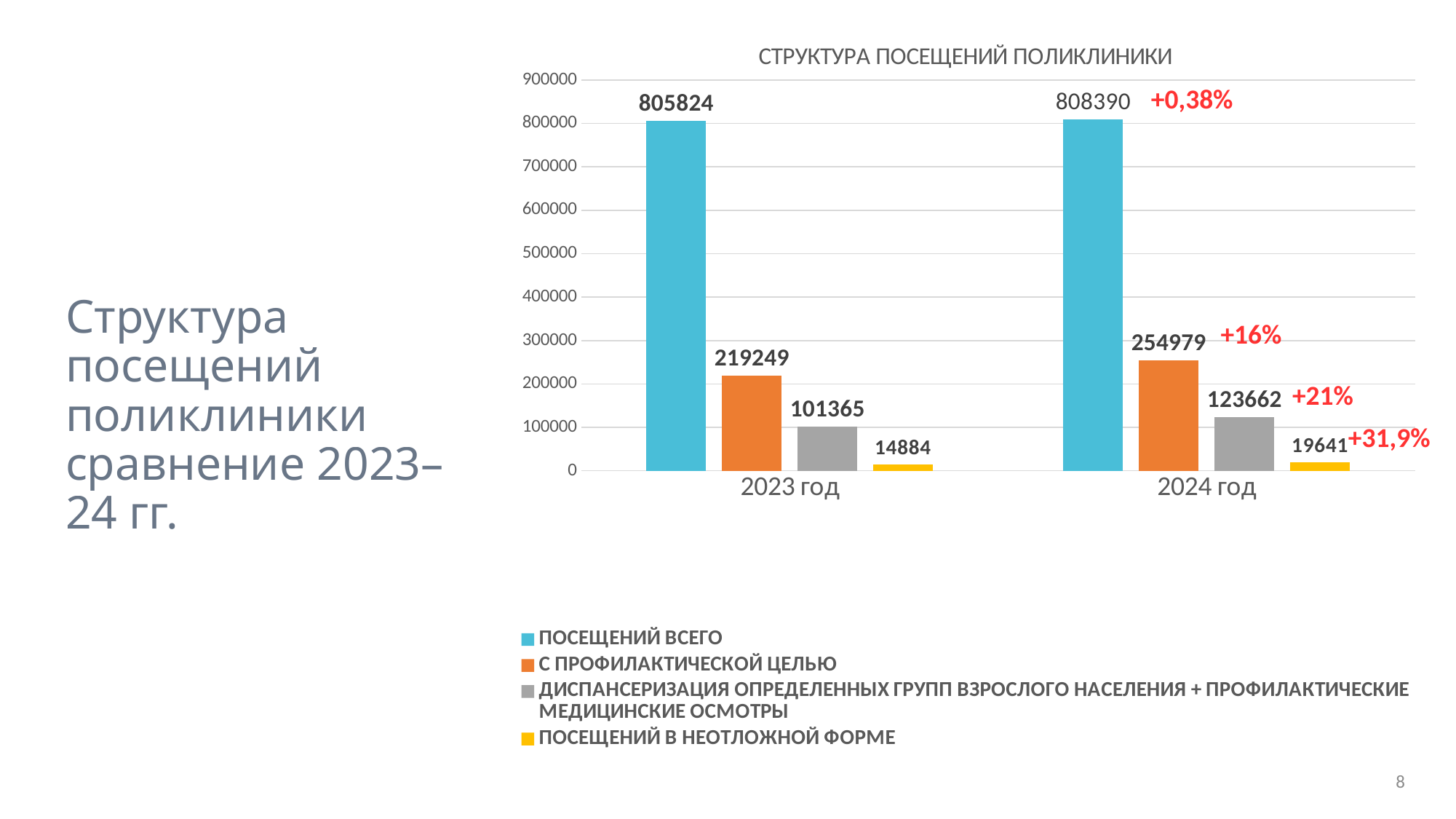
What is the value for ПОСЕЩЕНИЙ ВСЕГО in 2024 год? 808390 What is the difference between the С ПРОФИЛАКТИЧЕСКОЙ ЦЕЛЬЮ values for 2024 год and 2023 год? 35730 Which series has the lowest value in 2024 год? ПОСЕЩЕНИЙ В НЕОТЛОЖНОЙ ФОРМЕ What percentage change is annotated next to the С ПРОФИЛАКТИЧЕСКОЙ ЦЕЛЬЮ bar for 2024 год? +16% What is the value for ПОСЕЩЕНИЙ ВСЕГО in 2023 год? 805824 What kind of chart is shown on the slide? Bar chart What is the value for С ПРОФИЛАКТИЧЕСКОЙ ЦЕЛЬЮ in 2024 год? 254979 How many series does the legend list? 4 What is the difference between the ПОСЕЩЕНИЙ В НЕОТЛОЖНОЙ ФОРМЕ values for 2024 год and 2023 год? 4757 What is the value for ПОСЕЩЕНИЙ В НЕОТЛОЖНОЙ ФОРМЕ in 2023 год? 14884 Which series has the highest value in 2023 год? ПОСЕЩЕНИЙ ВСЕГО Which is larger: the ДИСПАНСЕРИЗАЦИЯ ОПРЕДЕЛЕННЫХ ГРУПП ВЗРОСЛОГО НАСЕЛЕНИЯ + ПРОФИЛАКТИЧЕСКИЕ МЕДИЦИНСКИЕ ОСМОТРЫ value in 2023 год or in 2024 год? 2024 год